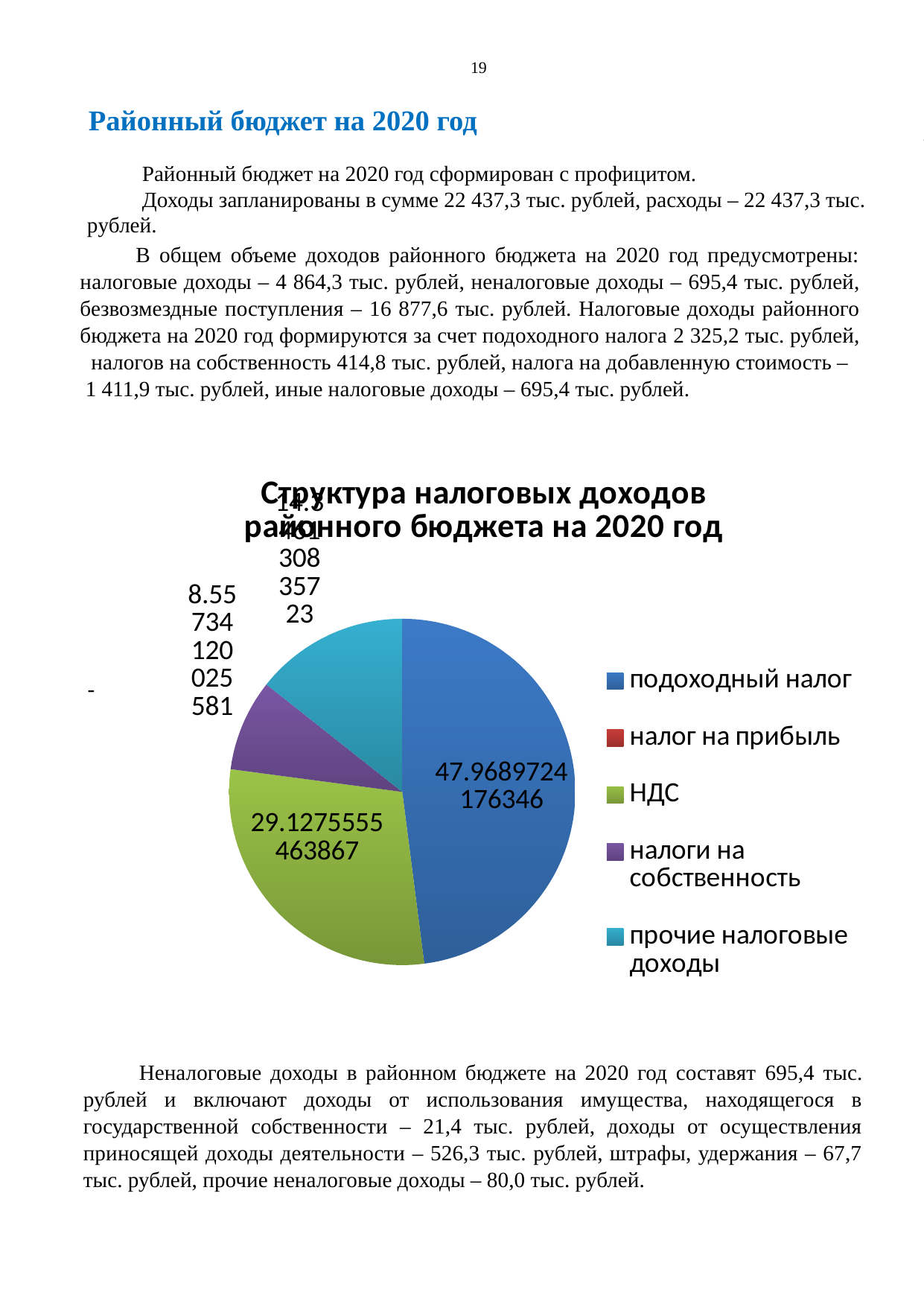
How many slices are visibly drawn in the pie? 4 Which slice is larger, НДС or прочие налоговые доходы? НДС What value is labelled on the slice for подоходный налог? 47.9689724176346 What colour is the slice for подоходный налог? blue Which slice is larger, налоги на собственность or прочие налоговые доходы? прочие налоговые доходы What kind of chart is shown on the slide? pie chart What value is labelled on the slice for налоги на собственность? 8.55734120025581 Which of the visible slices is the smallest? налоги на собственность How many entries does the chart legend list? 5 What is the title of the chart? Структура налоговых доходов районного бюджета на 2020 год What value is labelled on the slice for НДС? 29.1275555463867 Which category has the largest slice of the pie? подоходный налог